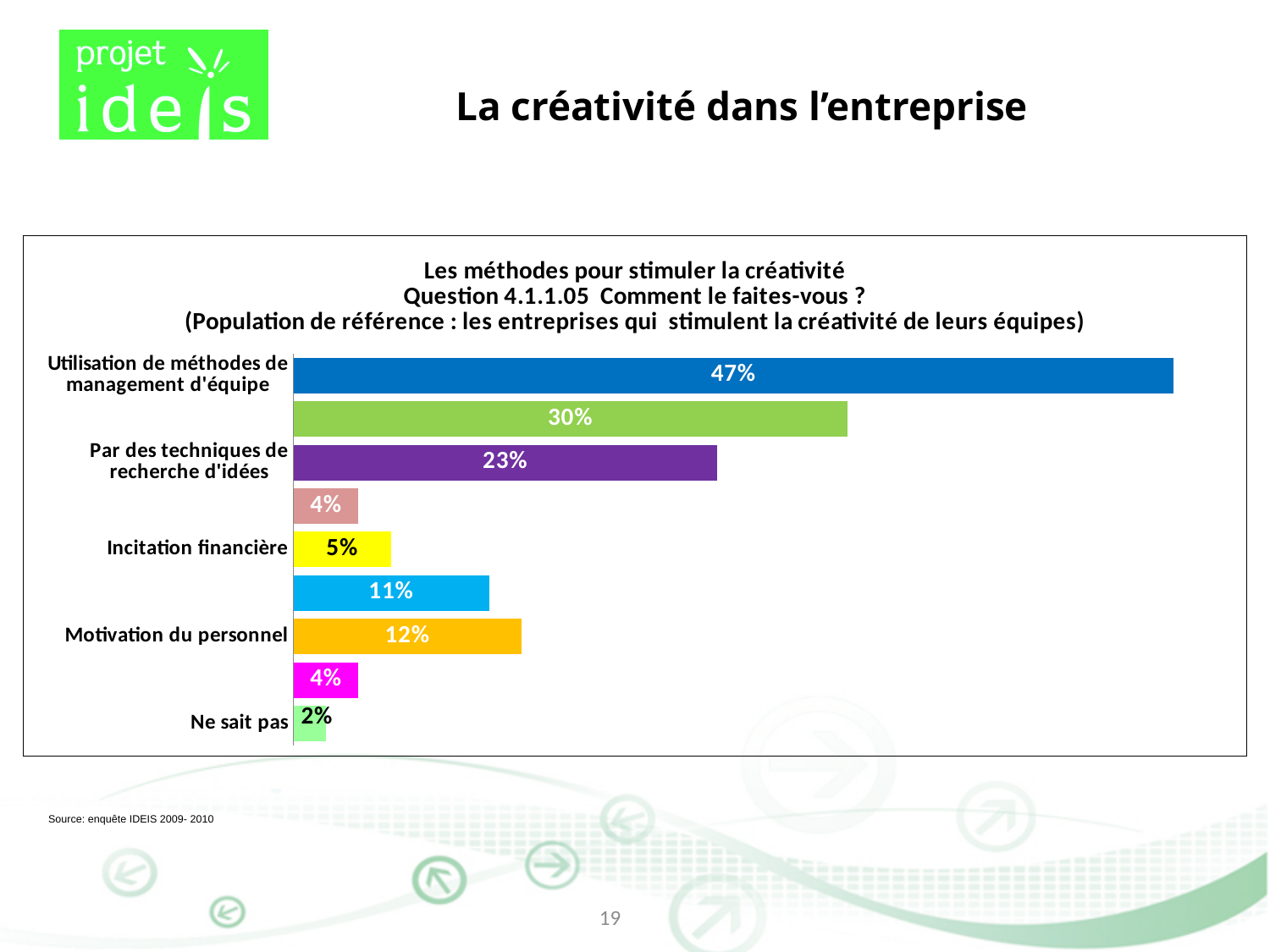
What is the first line of the chart's title? Les méthodes pour stimuler la créativité What is the value for "Motivation du personnel"? 12% What is the difference between the values for "Utilisation de méthodes de management d'équipe" and "Par des techniques de recherche d'idées"? 24 percentage points Which category has the highest value in the chart? Utilisation de méthodes de management d'équipe Which is larger, the value for "Incitation financière" or the value for "Motivation du personnel"? Motivation du personnel What is the value for "Par des techniques de recherche d'idées"? 23% What is the value for "Utilisation de méthodes de management d'équipe"? 47% Which category has the lowest value in the chart? Ne sait pas What is the value for "Ne sait pas"? 2% What is the value for "Incitation financière"? 5% How many bars are plotted in the chart? 9 What kind of chart is shown on the slide? Bar chart